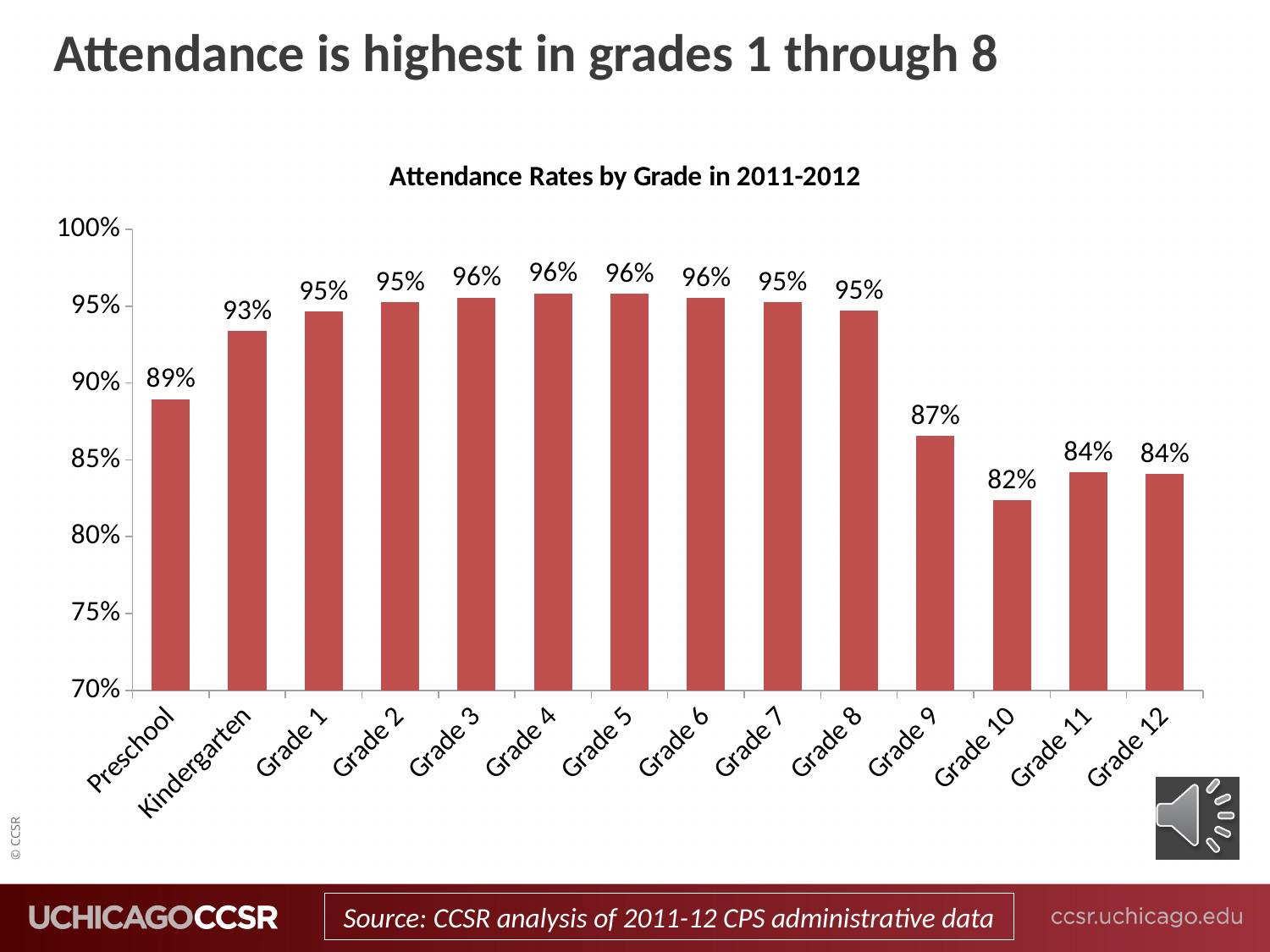
What is the title of the chart? Attendance Rates by Grade in 2011-2012 Which grade has the lowest attendance rate? Grade 10 What kind of chart is shown on the slide? bar chart Is the attendance rate for Grade 9 greater or less than 85%? greater What is the attendance rate for Kindergarten? 93% How many grade categories are shown on the x axis? 14 What is the attendance rate for Grade 10? 82% Which has a higher attendance rate, Kindergarten or Grade 9? Kindergarten What is the attendance rate for Preschool? 89% What is the attendance rate for Grade 9? 87% Do attendance rates rise or fall from Grade 8 to Grade 10? fall What is the difference in attendance rate between Preschool and Grade 10? 7 percentage points